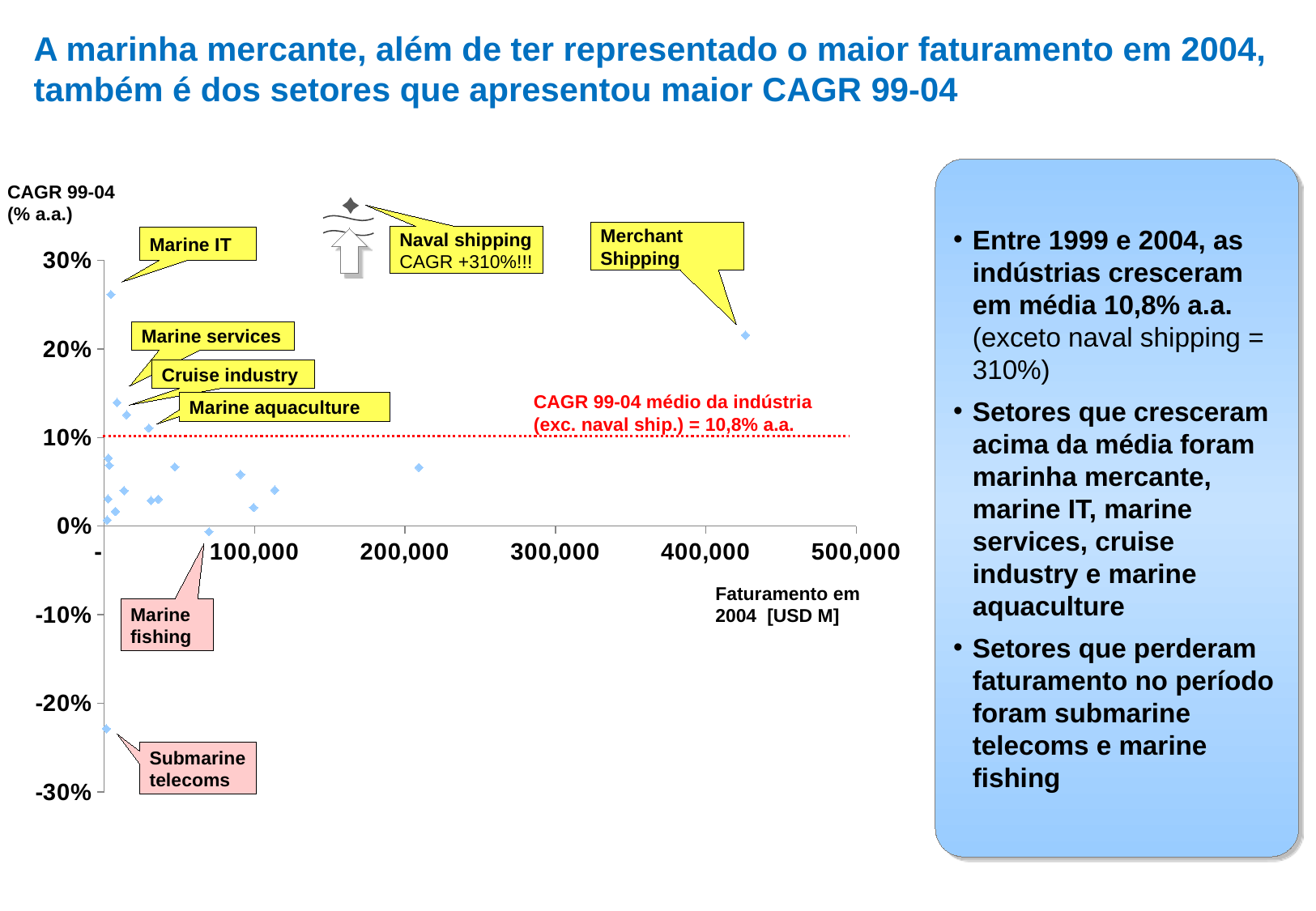
Is the CAGR 99-04 for Submarine telecoms greater or less than -20%? less What CAGR is given for Naval shipping in the callout? +310% Which labeled sector has the highest Faturamento em 2004 on the chart? Merchant Shipping Is the Faturamento em 2004 for Marine fishing greater or less than 100,000? less Which has the higher CAGR 99-04, Marine IT or Merchant Shipping? Marine IT Is the CAGR 99-04 for Marine IT greater or less than 20%? greater Which labeled sector has the lowest CAGR 99-04 on the chart? Submarine telecoms What kind of chart is shown on the slide? Scatter chart What is the industry average CAGR 99-04 (excluding naval shipping) shown by the dotted red line? 10,8% a.a. What is the label of the horizontal axis of the chart? Faturamento em 2004 [USD M] Among the points plotted on the chart, which labeled sector has the highest CAGR 99-04? Marine IT